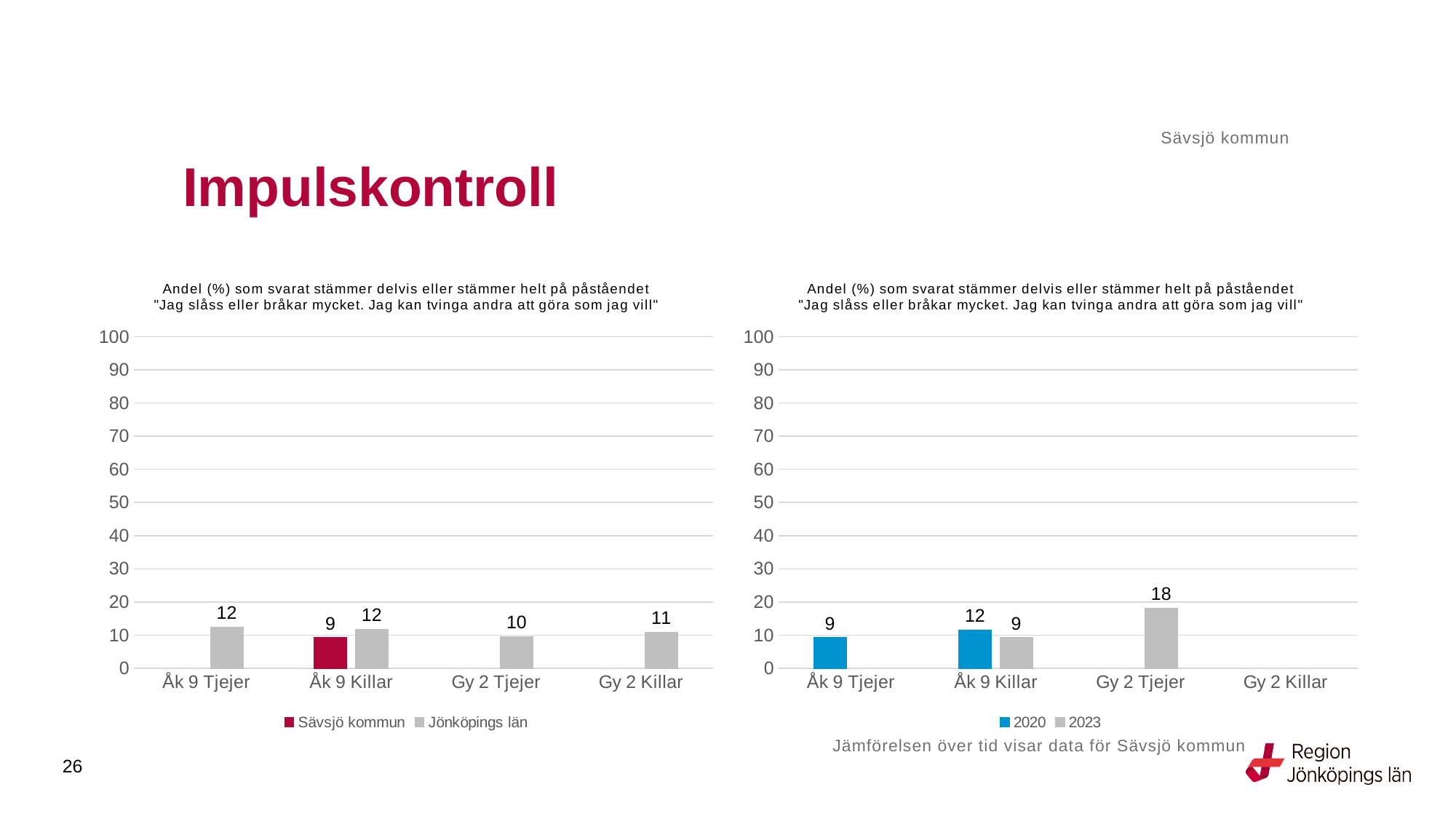
In the right chart, what is the difference between the 2020 and 2023 values for Åk 9 Killar? 3 In the left chart, what is the difference between Jönköpings län and Sävsjö kommun for Åk 9 Killar? 3 In the left chart, which category has the lowest Jönköpings län value? Gy 2 Tjejer In the right chart, what is the value for 2023 for Gy 2 Tjejer? 18 In the left chart, what is the value for Jönköpings län for Åk 9 Tjejer? 12 In the left chart, what is the value for Sävsjö kommun for Åk 9 Killar? 9 What kind of chart is the right chart? bar chart In the left chart, what is the value for Jönköpings län for Gy 2 Killar? 11 In the right chart, which is larger for Åk 9 Killar, the 2020 value or the 2023 value? 2020 In the left chart, how many series does the legend list? 2 In the right chart, what is the value for 2020 for Åk 9 Tjejer? 9 In the right chart, is the value for 2023 for Gy 2 Tjejer greater or less than 20? less